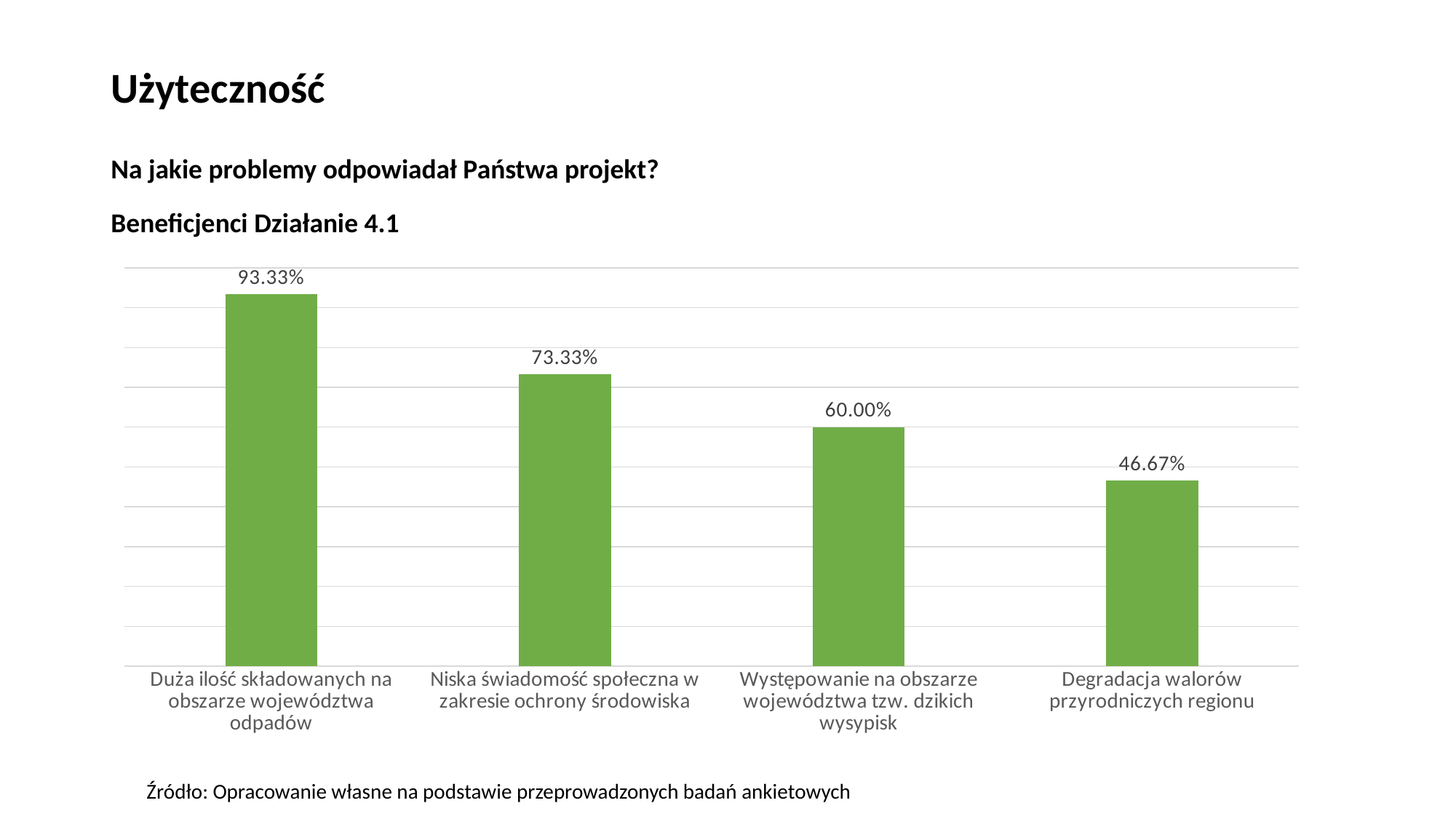
Which category has the lowest value? Degradacja walorów przyrodniczych regionu What is the difference between the values for "Niska świadomość społeczna w zakresie ochrony środowiska" and "Występowanie na obszarze województwa tzw. dzikich wysypisk"? 13.33% What is the value for "Niska świadomość społeczna w zakresie ochrony środowiska"? 73.33% What is the value for "Degradacja walorów przyrodniczych regionu"? 46.67% How many categories are shown in the chart? 4 What kind of chart is shown on the slide? Bar chart What is the value for "Występowanie na obszarze województwa tzw. dzikich wysypisk"? 60.00% Do the values rise or fall from left to right along the x axis? Fall Which is larger: the value for "Niska świadomość społeczna w zakresie ochrony środowiska" or for "Występowanie na obszarze województwa tzw. dzikich wysypisk"? Niska świadomość społeczna w zakresie ochrony środowiska What is the difference between the values for "Duża ilość składowanych na obszarze województwa odpadów" and "Degradacja walorów przyrodniczych regionu"? 46.66% What is the value for "Duża ilość składowanych na obszarze województwa odpadów"? 93.33% Which category has the highest value? Duża ilość składowanych na obszarze województwa odpadów